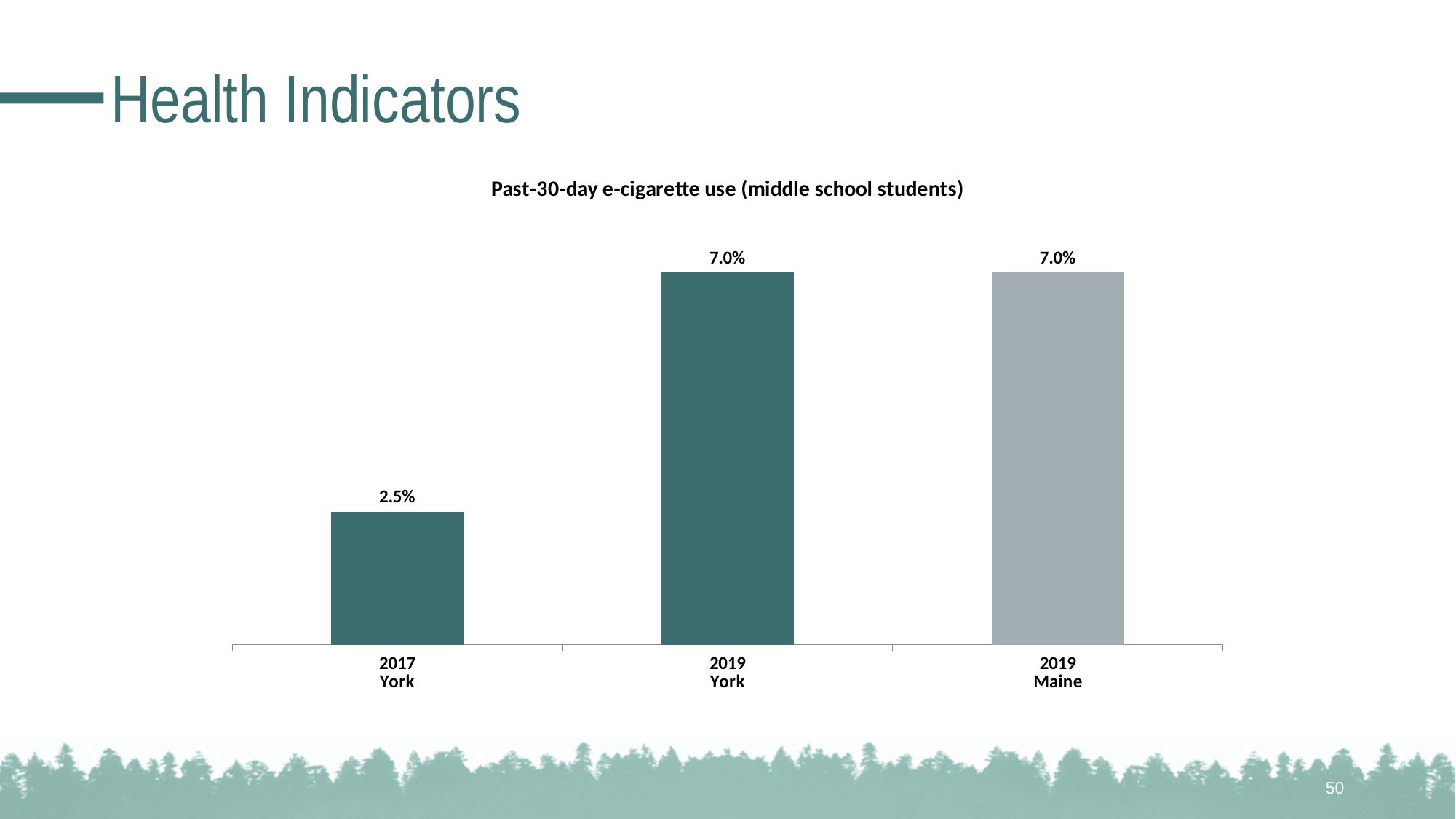
What is the title of the chart? Past-30-day e-cigarette use (middle school students) Which bar is shown in a lighter grey colour than the others? 2019 Maine Which is larger, the value for 2017 York or the value for 2019 York? 2019 York Which category has the lowest value? 2017 York What is the value for 2019 Maine? 7.0% What is the value for 2019 York? 7.0% What kind of chart is shown on the slide? Bar chart What is the value for 2017 York? 2.5% Does the value for York rise or fall from 2017 to 2019? Rise How many bars are shown in the chart? 3 What is the difference between the 2019 York value and the 2017 York value? 4.5%